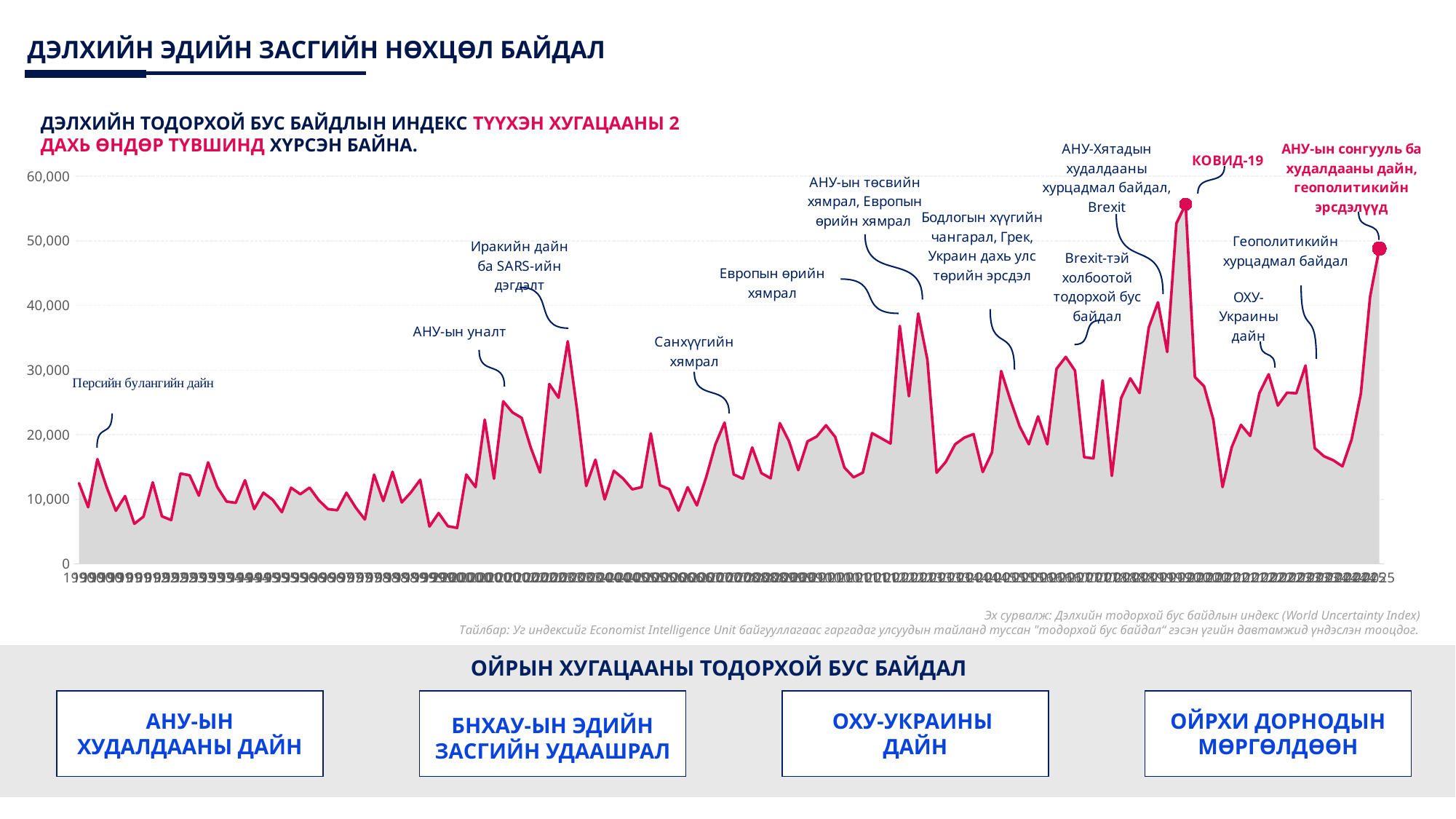
Is the value at the КОВИД-19 peak greater or less than 50,000? greater Is the value at the peak annotated 'Персийн булангийн дайн' greater or less than 20,000? less What colour is the line plotted on the chart? red Is the value at the peak annotated 'Санхүүгийн хямрал' greater or less than 30,000? less Overall, do the values rise or fall from the start of the chart in 1990 to the end in 2025? rise Which is higher: the peak annotated 'КОВИД-19' or the final point annotated 'АНУ-ын сонгууль ба худалдааны дайн, геополитикийн эрсдэлүүд'? КОВИД-19 Which annotated event marks the highest point on the chart? КОВИД-19 What kind of chart is shown on the slide? line chart What is the highest tick value shown on the vertical axis? 60,000